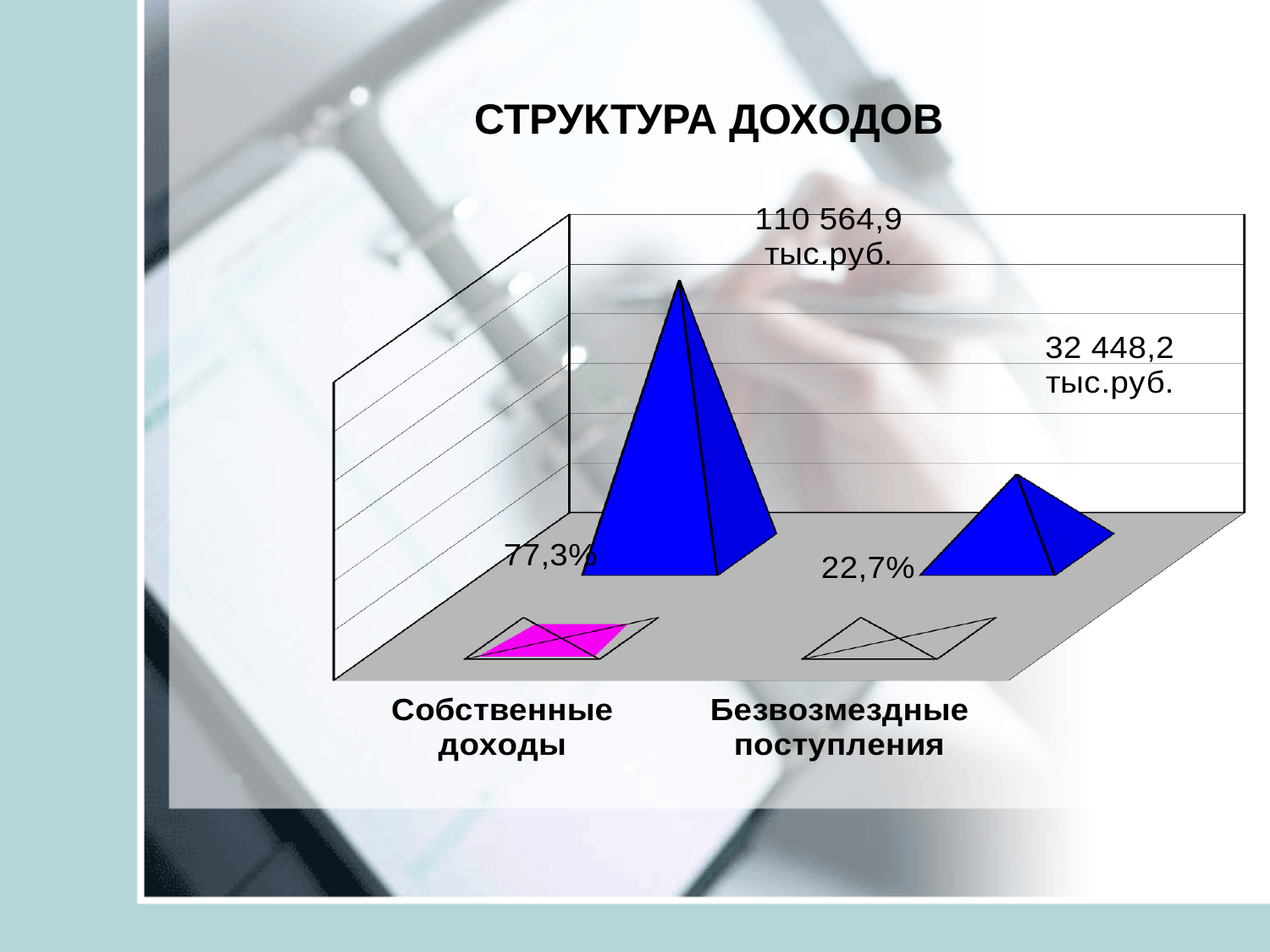
By how many percentage points does the share of Собственные доходы exceed that of Безвозмездные поступления? 54,6% What kind of chart is shown on the slide? bar chart What percentage share is shown for Безвозмездные поступления? 22,7% Which category has the highest value? Собственные доходы How many categories are shown in the chart? 2 What is the value for Собственные доходы? 110 564,9 тыс.руб. What percentage share is shown for Собственные доходы? 77,3% Which is larger, the value for Собственные доходы or for Безвозмездные поступления? Собственные доходы What is the difference between the values for Собственные доходы and Безвозмездные поступления? 78 116,7 тыс.руб. Which category has the lowest value? Безвозмездные поступления What is the value for Безвозмездные поступления? 32 448,2 тыс.руб. What is the title of the chart? СТРУКТУРА ДОХОДОВ